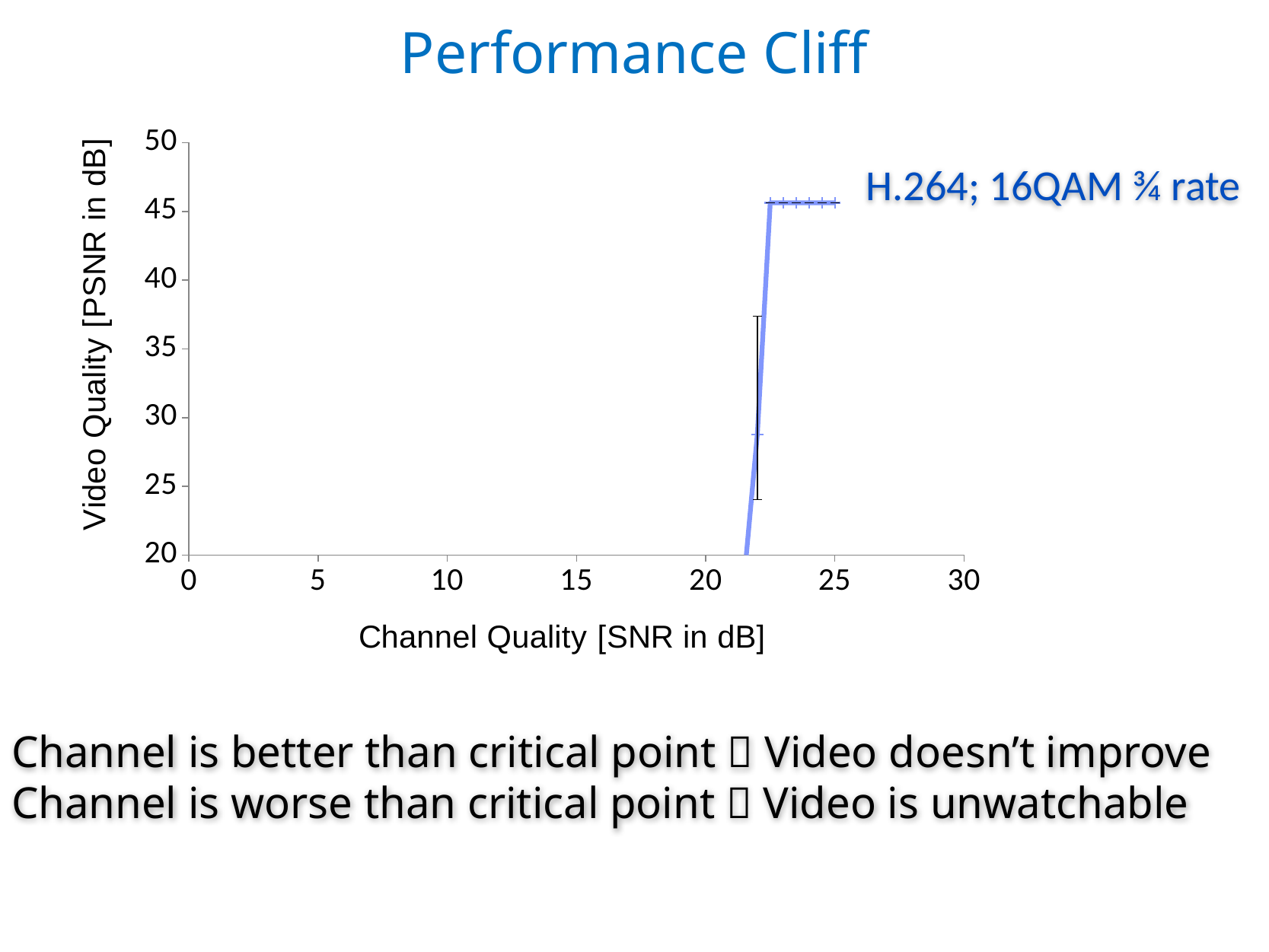
Is the video quality (PSNR) at a channel quality of 24 dB greater or less than 50? less What kind of chart is shown on the slide? line chart Is the video quality (PSNR) at a channel quality of 22 dB greater or less than 35? less How many data series are plotted on the chart? 1 What is the label of the series plotted on the chart? H.264; 16QAM ¾ rate What is the title of the chart on the slide? Performance Cliff Which has the higher video quality: a channel quality of 22 dB or 25 dB? 25 dB Does the video quality rise or fall as channel quality increases from 20 dB to 25 dB? rise Is the video quality (PSNR) at a channel quality of 25 dB greater or less than 40? greater What is the maximum value shown on the y axis of the chart? 50